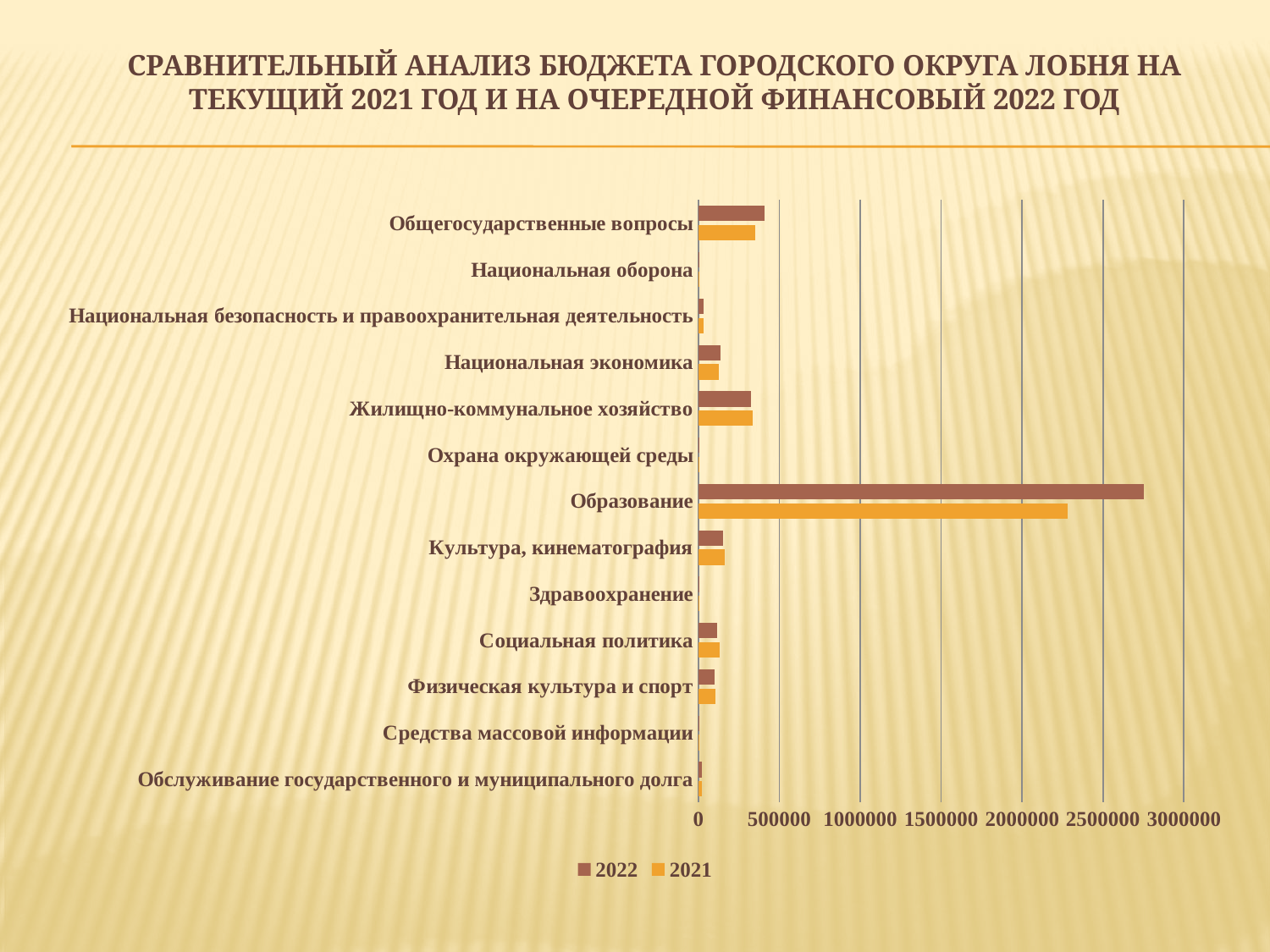
For Образование, which series has the larger value, 2022 or 2021? 2022 Which category has the highest value for the 2021 series? Образование How many categories are shown on the vertical axis of the chart? 13 What is the highest value shown on the horizontal axis? 3000000 How many series does the legend list? 2 Is the 2022 value for Образование greater or less than 2500000? greater Is the 2021 value for Образование greater or less than 2000000? greater Is the 2022 value for Общегосударственные вопросы greater or less than 500000? less Which category has the highest value for the 2022 series? Образование Which series is shown in orange in the legend? 2021 What kind of chart is shown on the slide? bar chart